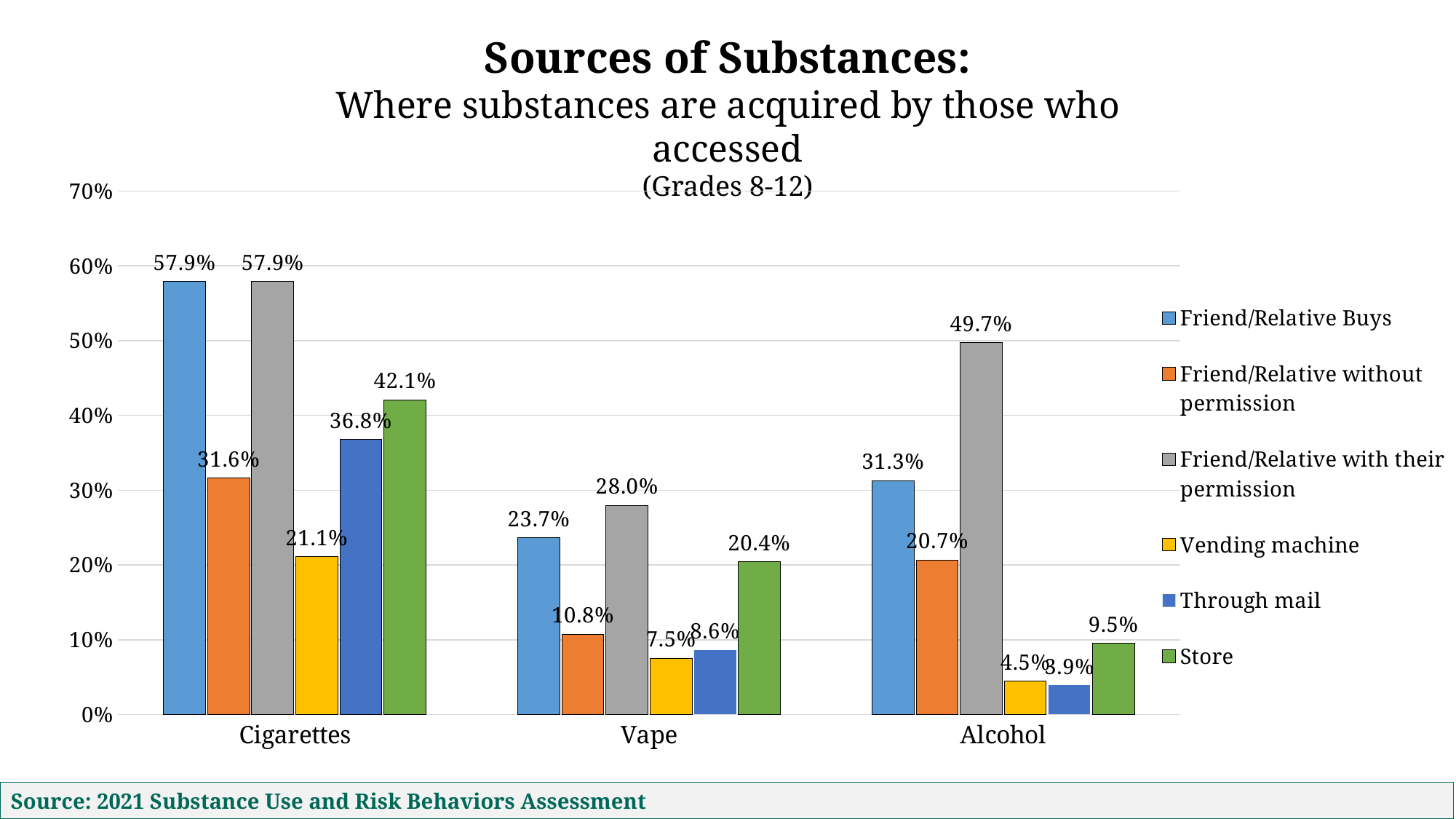
What is the value for Vending machine in the Vape category? 7.5% How many substance categories are shown on the x axis? 3 Which source has the highest value in the Alcohol category? Friend/Relative with their permission In the Cigarettes category, what is the difference between the Store value and the Through mail value? 5.3 percentage points Which series is shown in green in the legend? Store What is the value for Store in the Cigarettes category? 42.1% How many series does the legend list? 6 Is the value for Through mail in the Alcohol category greater or less than 10%? less Which source has the lowest value in the Vape category? Vending machine What is the value for Friend/Relative with their permission in the Alcohol category? 49.7% What kind of chart is shown on the slide? bar chart In the Vape category, which is larger: Friend/Relative Buys or Store? Friend/Relative Buys